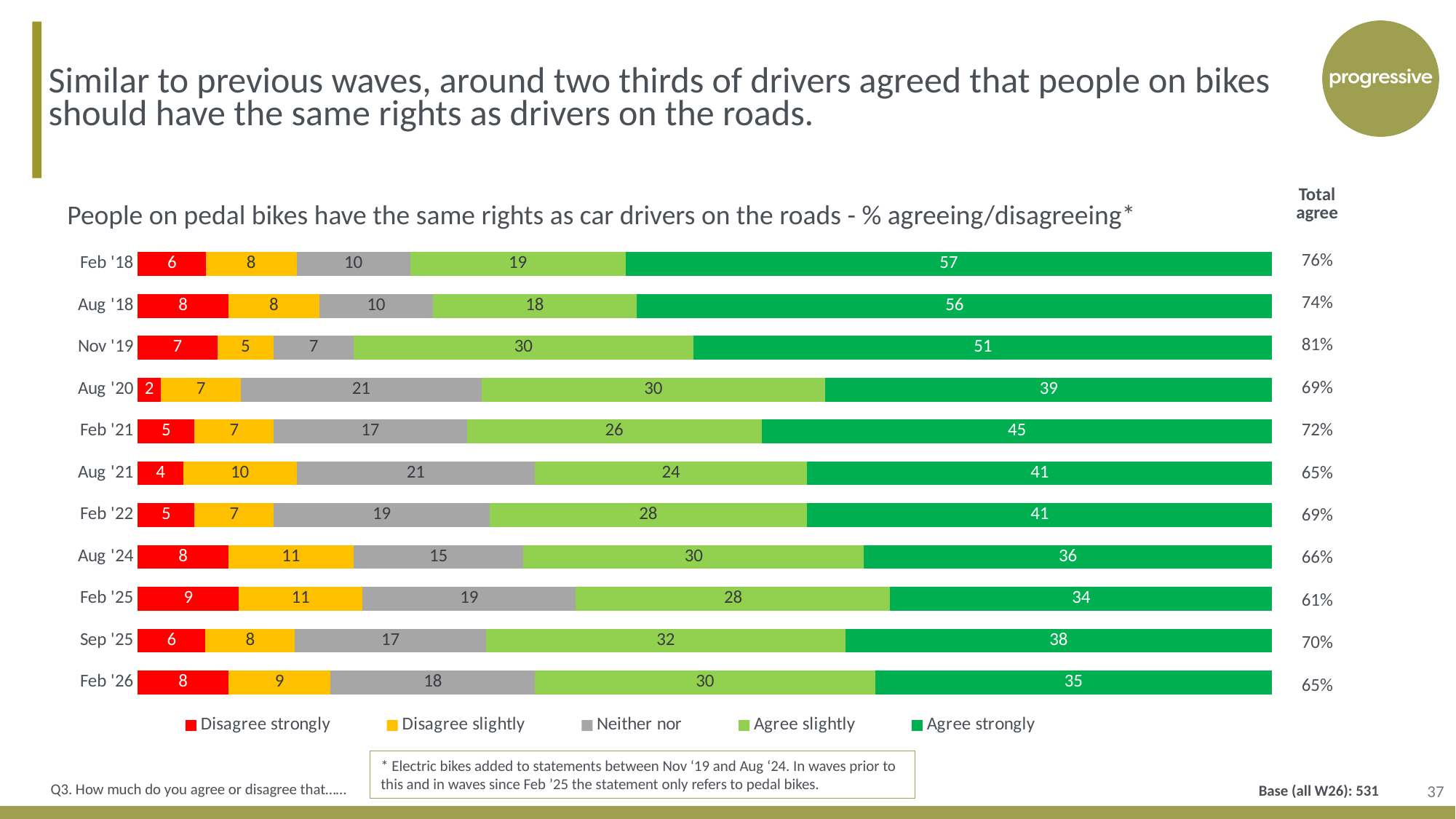
What is the Total agree figure shown for Nov '19? 81% Which wave has the highest Agree strongly value? Feb '18 Which colour represents Disagree strongly in the legend? Red How many series does the legend list? 5 What kind of chart is shown on the slide? Stacked bar chart What is the total of the stacked bar for Feb '26? 100 What is the difference between the Agree slightly values for Nov '19 and Feb '18? 11 Which wave has the lowest Disagree strongly value? Aug '20 How many waves (bars) are shown in the chart? 11 Which wave has the larger Agree strongly value, Aug '24 or Feb '25? Aug '24 What is the value for Neither nor in the Aug '20 wave? 21 What is the value for Agree strongly in the Feb '18 wave? 57